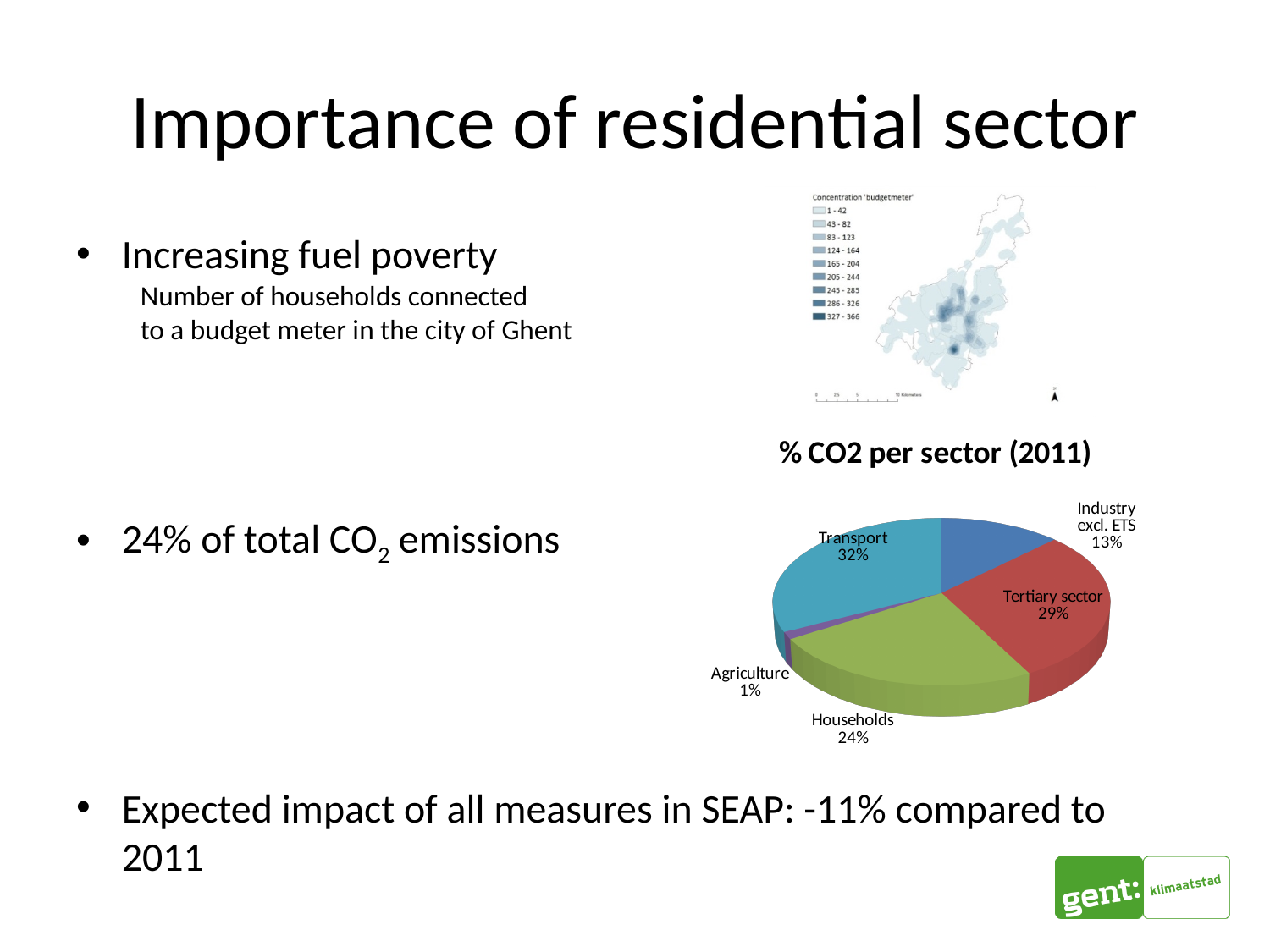
In the % CO2 per sector (2011) chart, what share of CO2 emissions comes from Industry excl. ETS? 13% Which sector has the smallest share in the % CO2 per sector (2011) chart? Agriculture In the % CO2 per sector (2011) chart, what share of CO2 emissions comes from Transport? 32% In the % CO2 per sector (2011) chart, how many percentage points larger is the Transport share than the Households share? 8 In the % CO2 per sector (2011) chart, what share of CO2 emissions comes from Agriculture? 1% What is the title of the pie chart on the slide? % CO2 per sector (2011) What type of chart is used to show % CO2 per sector (2011)? Pie chart How many sectors are shown in the % CO2 per sector (2011) pie chart? 5 In the % CO2 per sector (2011) chart, which has a larger share: Tertiary sector or Industry excl. ETS? Tertiary sector In the % CO2 per sector (2011) chart, what share of CO2 emissions comes from Households? 24% In the % CO2 per sector (2011) chart, what share of CO2 emissions comes from the Tertiary sector? 29% Which sector has the largest share in the % CO2 per sector (2011) chart? Transport